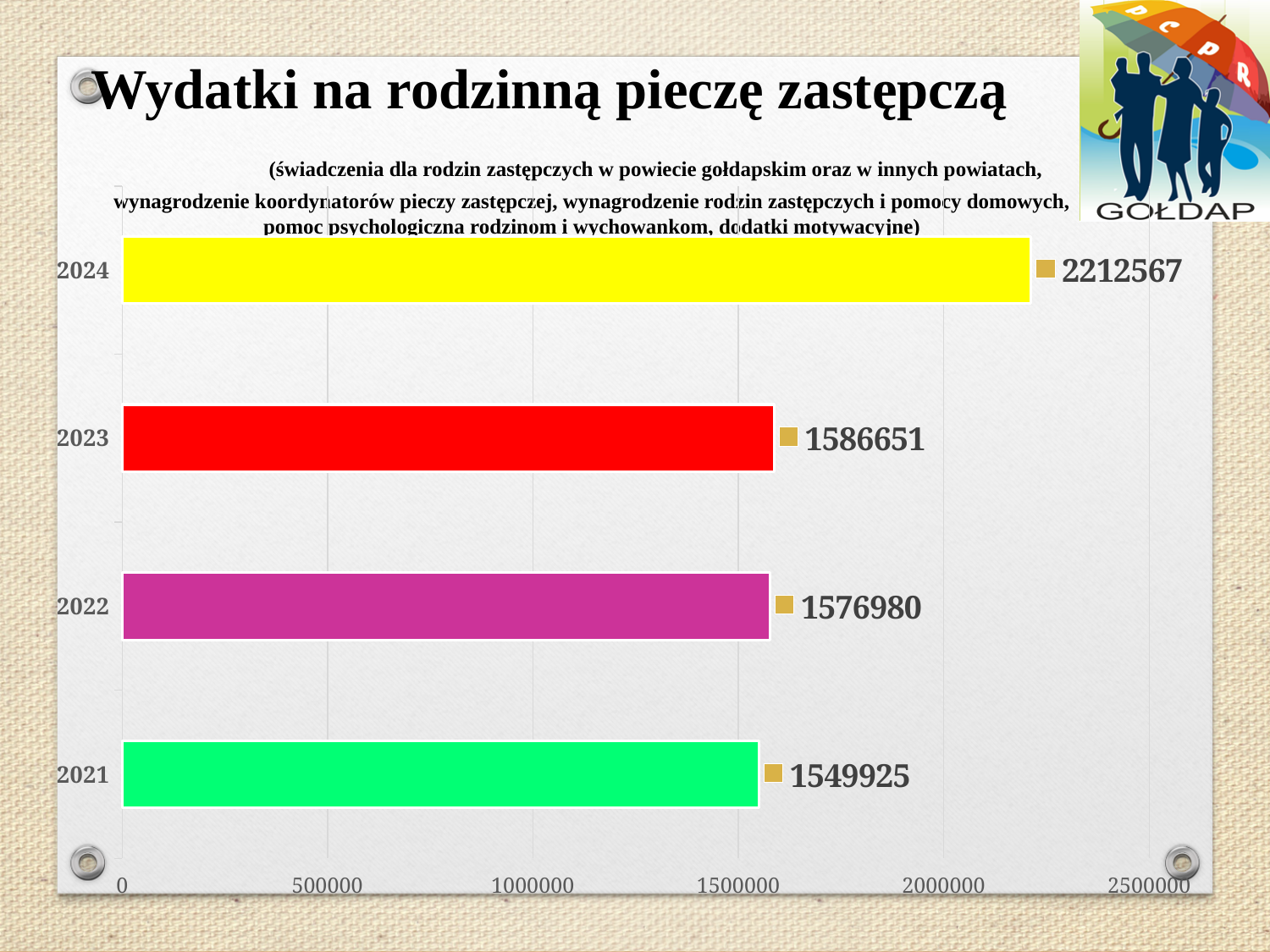
What is the difference between the values for 2022 and 2021? 27055 What is the value for 2024? 2212567 Which year has the lowest value? 2021 What is the value for 2022? 1576980 Is the value for 2024 greater or less than 2000000? greater Which is larger, the value for 2023 or the value for 2022? 2023 What is the value for 2021? 1549925 How many years are shown in the chart? 4 What is the difference between the values for 2024 and 2023? 625916 Which year has the highest value? 2024 What colour is the bar for 2023? red What kind of chart is shown on the slide? bar chart